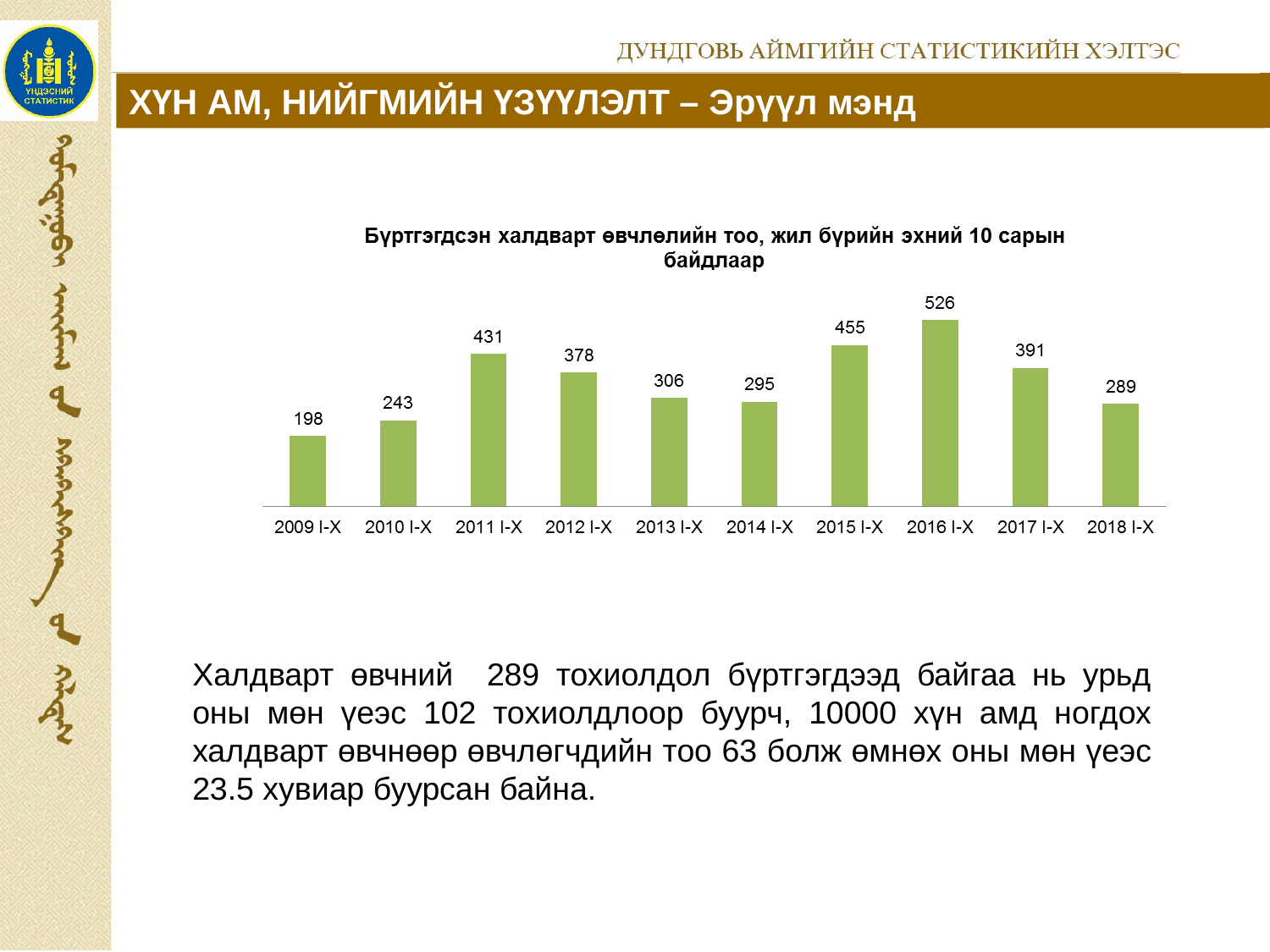
What is the value for 2013 I-X? 306 What is the value for 2009 I-X? 198 Which category has the highest value? 2016 I-X What is the difference between the values for 2016 I-X and 2015 I-X? 71 What kind of chart is shown on the slide? bar chart What is the value for 2016 I-X? 526 Do the values rise or fall from 2016 I-X to 2018 I-X? fall What is the title of the chart? Бүртгэгдсэн халдварт өвчлөлийн тоо, жил бүрийн эхний 10 сарын байдлаар What is the difference between the values for 2017 I-X and 2018 I-X? 102 How many categories are shown on the x axis? 10 Which category has the lowest value? 2009 I-X Which is larger, the value for 2011 I-X or the value for 2012 I-X? 2011 I-X